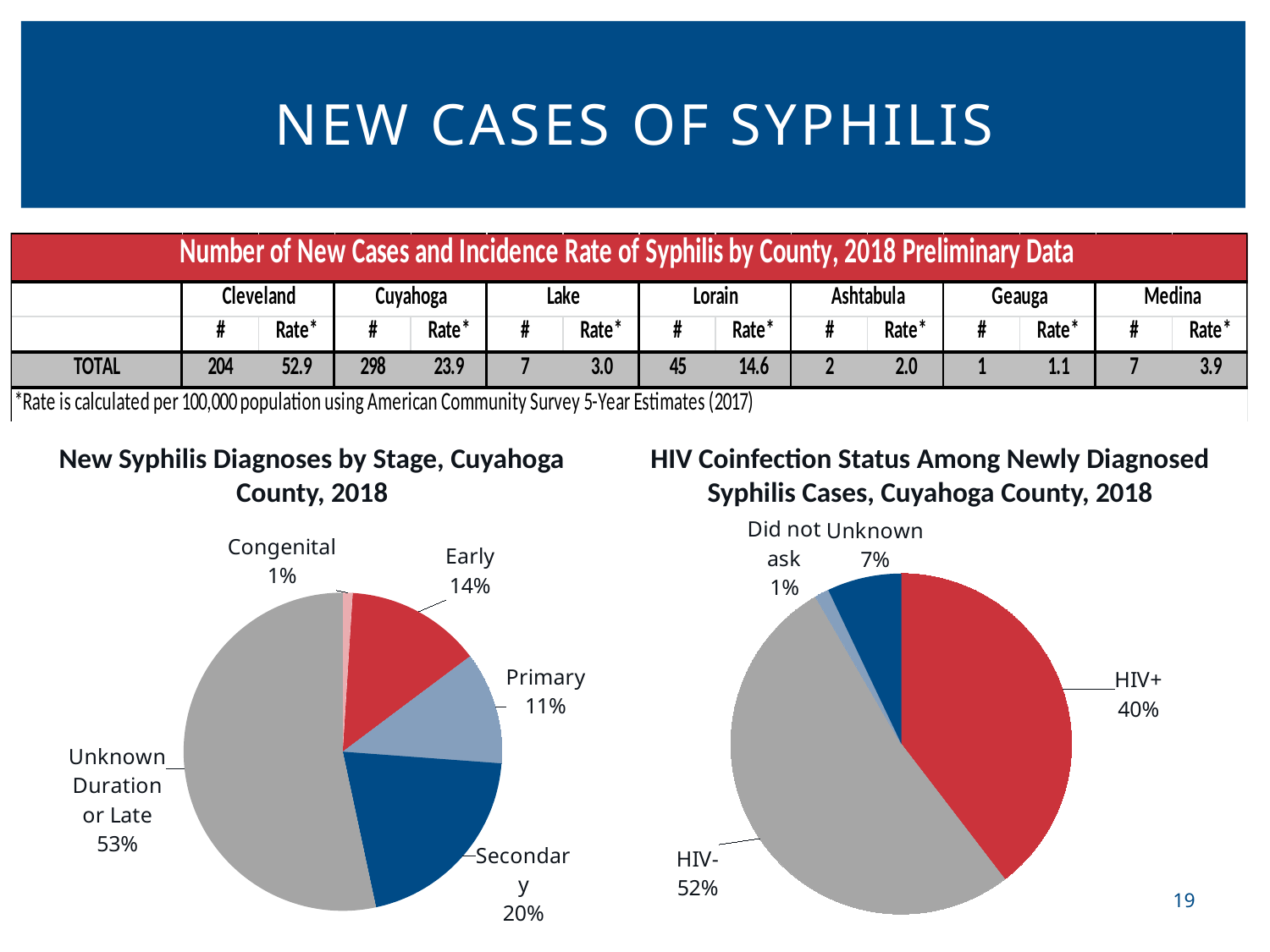
In the 'New Syphilis Diagnoses by Stage, Cuyahoga County, 2018' chart, what is the difference in percentage points between Secondary and Primary? 9 percentage points In the 'New Syphilis Diagnoses by Stage, Cuyahoga County, 2018' chart, which stage has the largest share? Unknown Duration or Late In the 'New Syphilis Diagnoses by Stage, Cuyahoga County, 2018' chart, which stage has the smallest share? Congenital What kind of chart is 'HIV Coinfection Status Among Newly Diagnosed Syphilis Cases, Cuyahoga County, 2018'? Pie chart In the 'HIV Coinfection Status Among Newly Diagnosed Syphilis Cases, Cuyahoga County, 2018' chart, what is the difference in percentage points between HIV- and HIV+? 12 percentage points In the 'HIV Coinfection Status Among Newly Diagnosed Syphilis Cases, Cuyahoga County, 2018' chart, how many categories are shown? 4 In the 'New Syphilis Diagnoses by Stage, Cuyahoga County, 2018' chart, what share of diagnoses is Early? 14% In the 'New Syphilis Diagnoses by Stage, Cuyahoga County, 2018' chart, how many stage categories are shown? 5 In the 'New Syphilis Diagnoses by Stage, Cuyahoga County, 2018' chart, which is larger, Early or Primary? Early In the 'HIV Coinfection Status Among Newly Diagnosed Syphilis Cases, Cuyahoga County, 2018' chart, what share of cases is HIV+? 40% In the 'HIV Coinfection Status Among Newly Diagnosed Syphilis Cases, Cuyahoga County, 2018' chart, which category has the largest share? HIV- In the 'New Syphilis Diagnoses by Stage, Cuyahoga County, 2018' chart, what share of diagnoses is Secondary? 20%